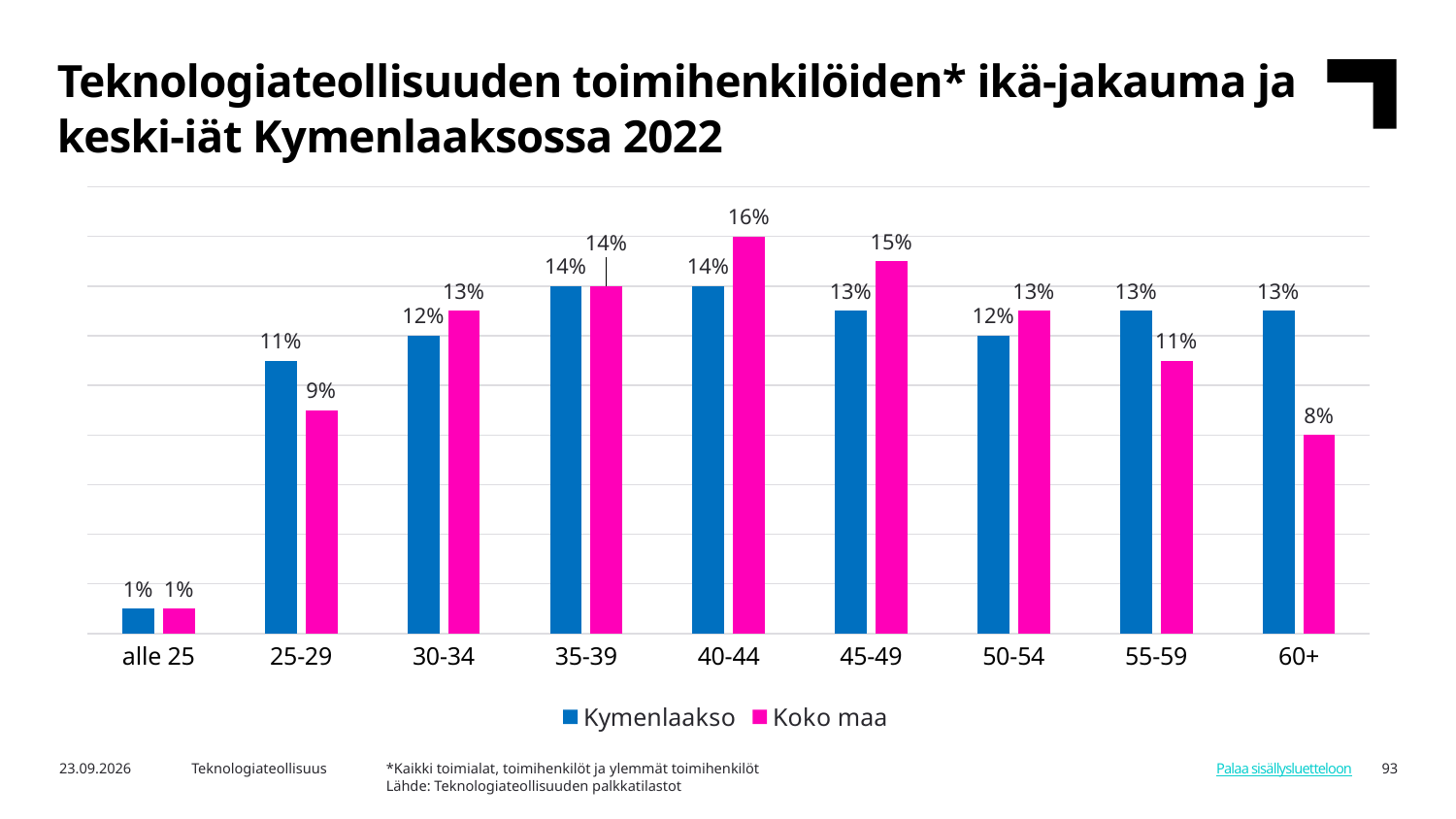
Which age group has the lowest Kymenlaakso value? alle 25 For the 55-59 age group, which is larger: Kymenlaakso or Koko maa? Kymenlaakso What kind of chart is shown on the slide? Bar chart How many age groups are shown on the x axis? 9 How many series does the legend list? 2 What is the Kymenlaakso value for the 25-29 age group? 11% What is the difference between the Kymenlaakso and Koko maa values for the 25-29 age group? 2% What is the Koko maa value for the 45-49 age group? 15% What is the Koko maa value for the 60+ age group? 8% For the 40-44 age group, which is larger: Kymenlaakso or Koko maa? Koko maa What is the difference between the Koko maa and Kymenlaakso values for the 60+ age group? 5% Which age group has the highest Koko maa value? 40-44